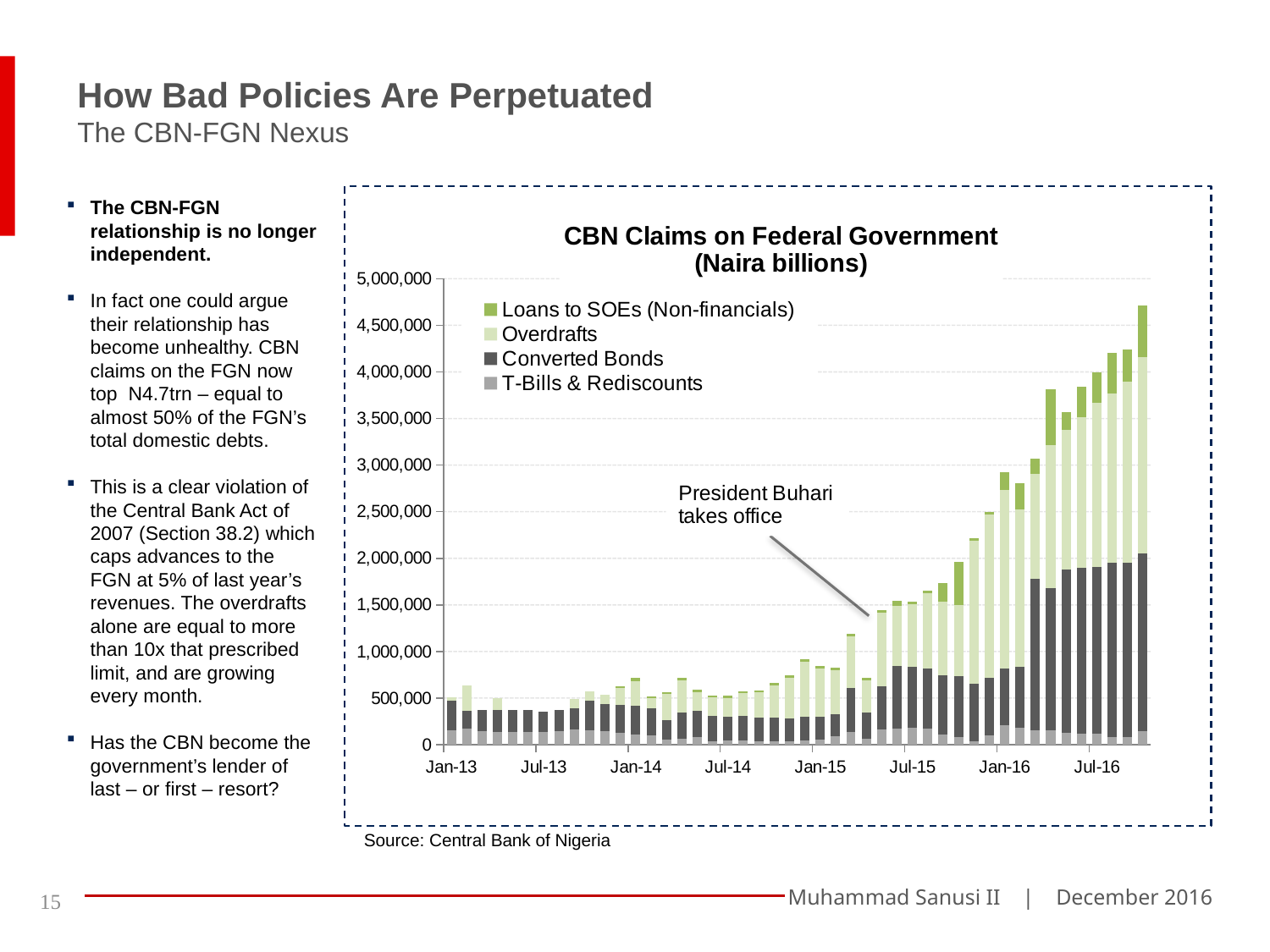
Do the total CBN claims on the Federal Government rise or fall from Jan-13 to Jul-16? Rise Is the total value of the bar at Jan-13 greater or less than 1,000,000? less Is the total value of the bar at Jul-15 greater or less than 1,000,000? greater Is the total value of the bar at Jan-16 greater or less than 2,500,000? greater How many series does the legend of the chart list? 4 What kind of chart is shown on the slide? Stacked bar chart Of the months labelled on the x axis, which has the highest total CBN claims? Jul-16 Which series is shown in the darkest grey in the chart? Converted Bonds What is the title of the chart? CBN Claims on Federal Government (Naira billions) Which has the larger total, the bar at Jan-13 or the bar at Jul-16? Jul-16